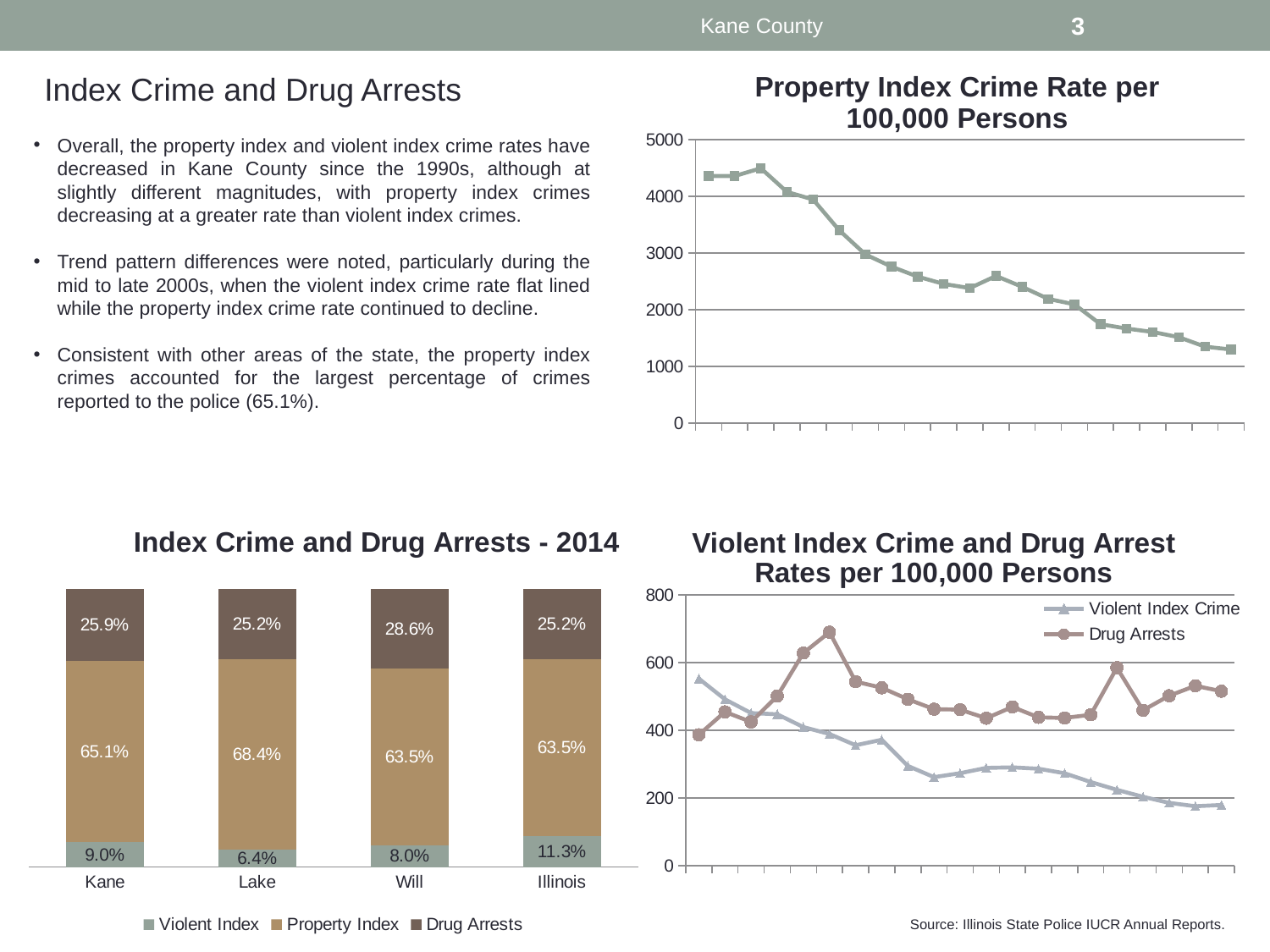
How many categories are shown on the x axis of the 'Index Crime and Drug Arrests - 2014' chart? 4 In the 'Index Crime and Drug Arrests - 2014' chart, what is the Violent Index value for Illinois? 11.3% In the 'Index Crime and Drug Arrests - 2014' chart, what is the Drug Arrests value for Will? 28.6% In the 'Index Crime and Drug Arrests - 2014' chart, what is the Property Index value for Lake? 68.4% In the 'Index Crime and Drug Arrests - 2014' chart, which category has the lowest Violent Index share? Lake In the 'Index Crime and Drug Arrests - 2014' chart, which category has the highest Violent Index share? Illinois In the 'Property Index Crime Rate per 100,000 Persons' chart, is the last plotted value greater or less than 2000? less What kind of chart is 'Index Crime and Drug Arrests - 2014'? Stacked bar chart In the 'Index Crime and Drug Arrests - 2014' chart, what is the difference between the Property Index values for Lake and Kane? 3.3 percentage points How many series does the legend of the 'Index Crime and Drug Arrests - 2014' chart list? 3 In the 'Index Crime and Drug Arrests - 2014' chart, which has the larger Drug Arrests share, Kane or Will? Will In the 'Property Index Crime Rate per 100,000 Persons' chart, do the values generally rise or fall along the x axis? Fall